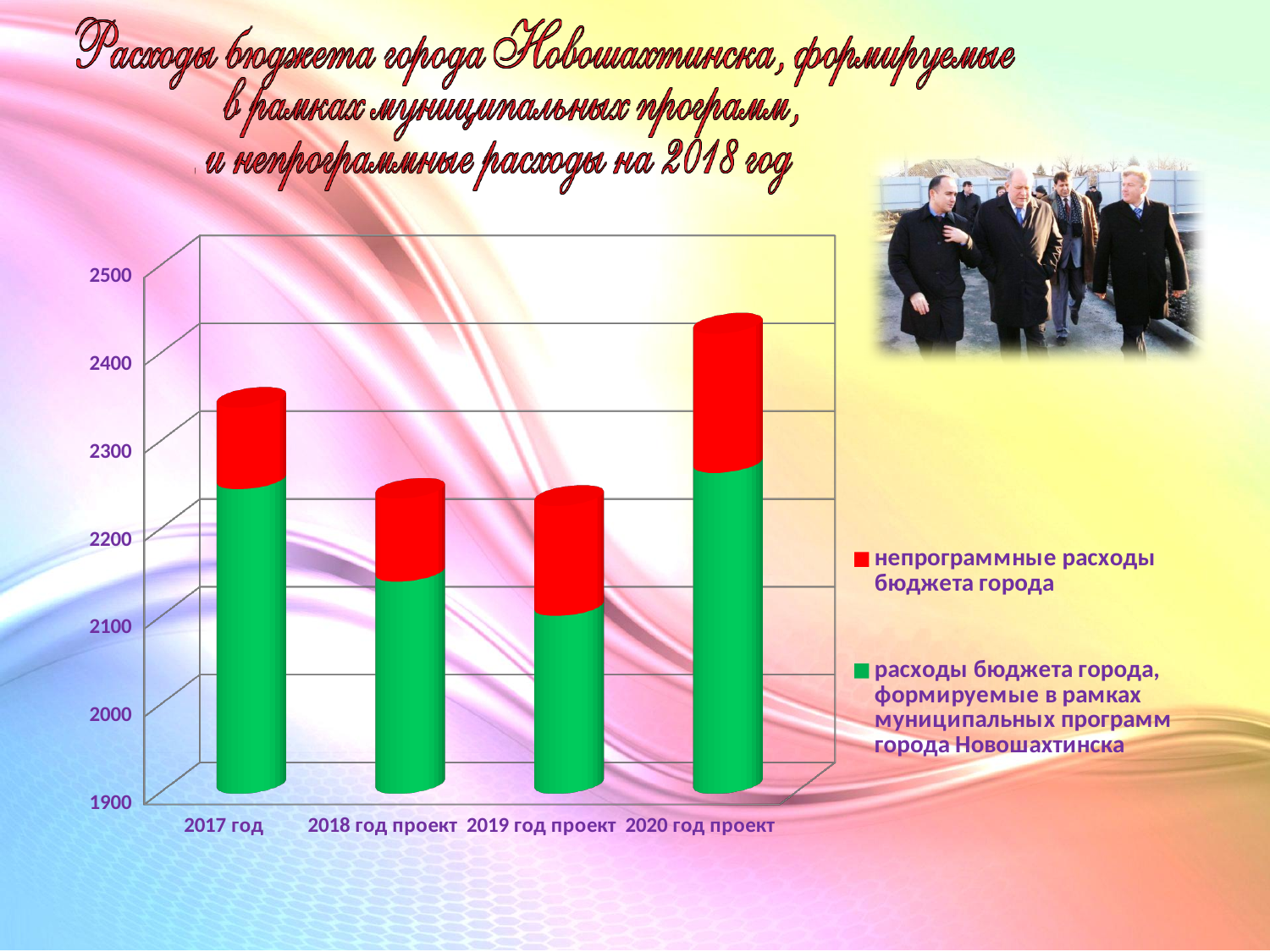
What kind of chart is shown on the slide? bar chart Is the total value of the bar for 2018 год проект greater or less than 2300? less Is the total value of the bar for 2017 год greater or less than 2300? greater Is the total value of the bar for 2020 год проект greater or less than 2400? greater Which year has the highest total bar in the chart? 2020 год проект What is the lowest value shown on the vertical axis of the chart? 1900 How many series does the chart legend list? 2 Which colour represents непрограммные расходы бюджета города in the chart? red Which is larger: the total bar for 2017 год or the total bar for 2019 год проект? 2017 год How many categories (years) are shown on the x axis of the chart? 4